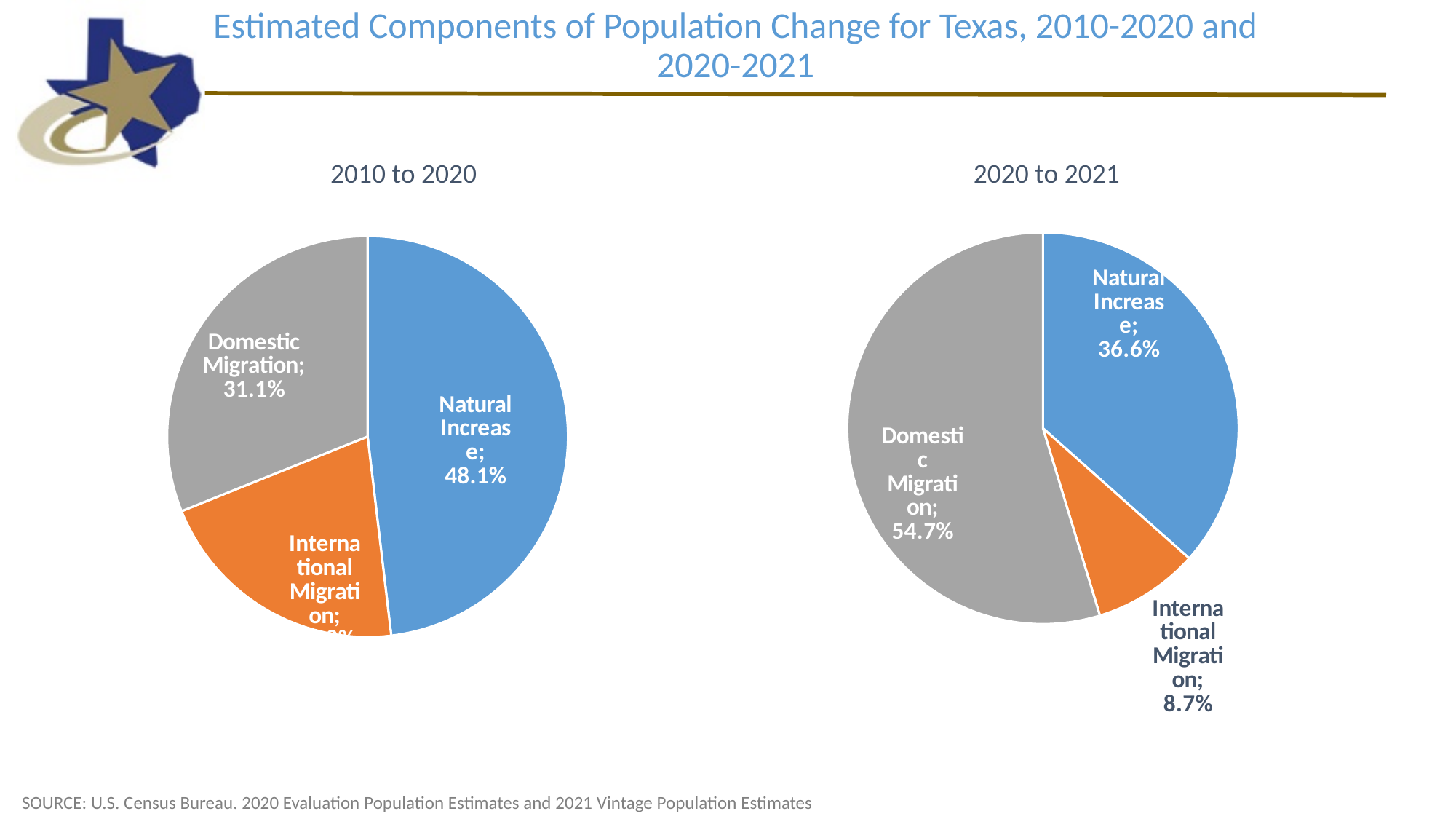
In the '2010 to 2020' pie chart, how many percentage points larger is Natural Increase than Domestic Migration? 17.0 In the '2020 to 2021' pie chart, what share is Domestic Migration? 54.7% In the '2010 to 2020' pie chart, which component has the largest share? Natural Increase Which is larger: Natural Increase in the '2010 to 2020' chart or Natural Increase in the '2020 to 2021' chart? 2010 to 2020 In the '2020 to 2021' pie chart, which component has the smallest share? International Migration What type of chart is used on this slide? Pie chart In the '2010 to 2020' pie chart, what share is Domestic Migration? 31.1% In the '2020 to 2021' pie chart, how many percentage points larger is Domestic Migration than Natural Increase? 18.1 In the '2010 to 2020' pie chart, what share is Natural Increase? 48.1% In the '2020 to 2021' pie chart, which component has the largest share? Domestic Migration In the '2020 to 2021' pie chart, what share is Natural Increase? 36.6% In the '2020 to 2021' pie chart, what share is International Migration? 8.7%